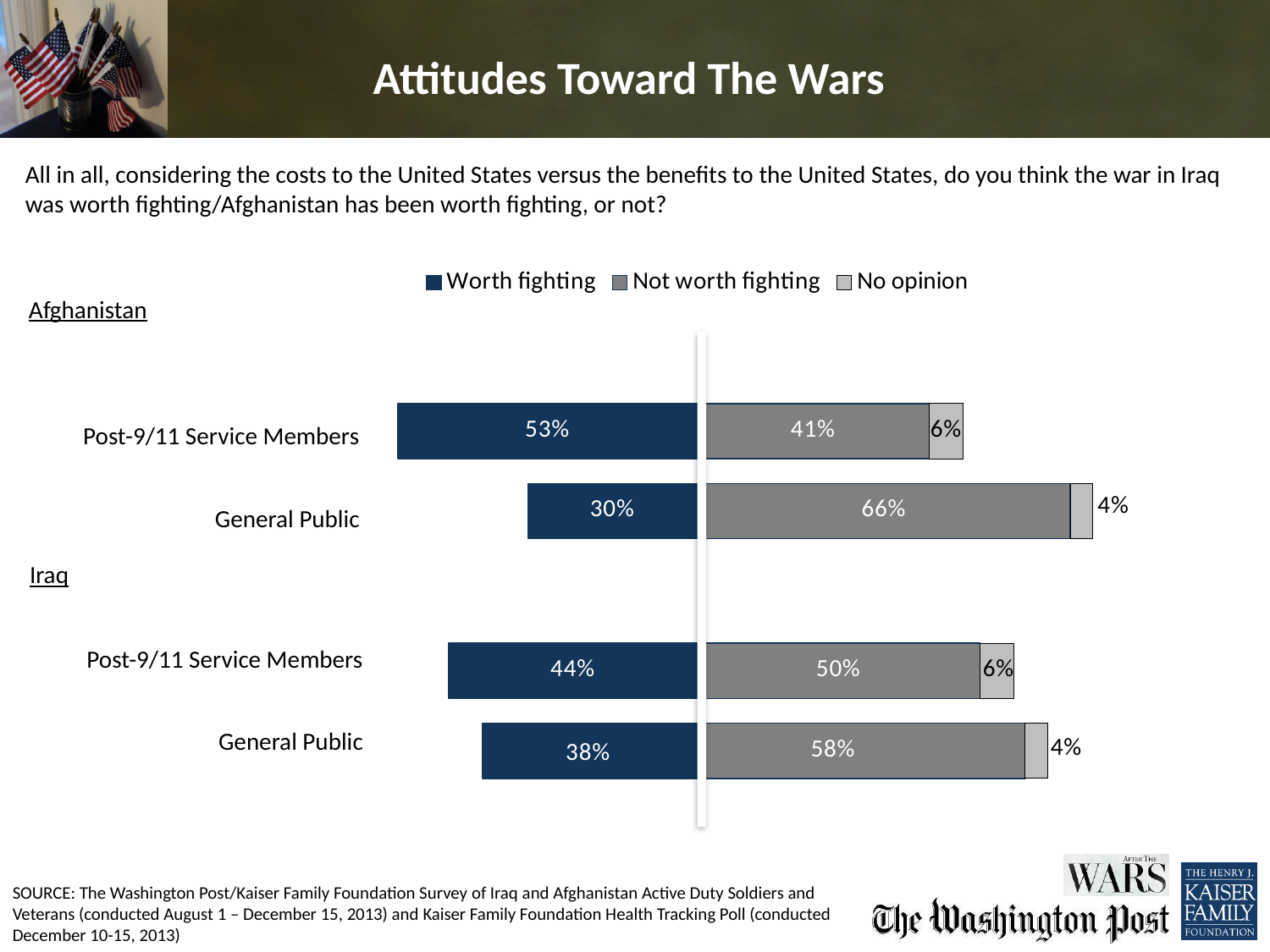
Which group and war has the lowest 'Worth fighting' percentage? General Public, Afghanistan What percentage of the General Public had no opinion on whether the war in Afghanistan was worth fighting? 4% For the war in Iraq, which is larger: the 'Not worth fighting' share among Post-9/11 Service Members or among the General Public? General Public What is the difference in percentage points between Post-9/11 Service Members and the General Public saying the war in Afghanistan was worth fighting? 23 percentage points What kind of chart is shown on the slide? Stacked bar chart What percentage of Post-9/11 Service Members said the war in Afghanistan was worth fighting? 53% How many series does the legend list? 3 What is the total of the stacked bar for the General Public on the war in Iraq? 100% Which group and war has the highest 'Worth fighting' percentage? Post-9/11 Service Members, Afghanistan What percentage of Post-9/11 Service Members said the war in Iraq was not worth fighting? 50% What percentage of the General Public said the war in Iraq was not worth fighting? 58% How many bars are plotted in the chart? 4